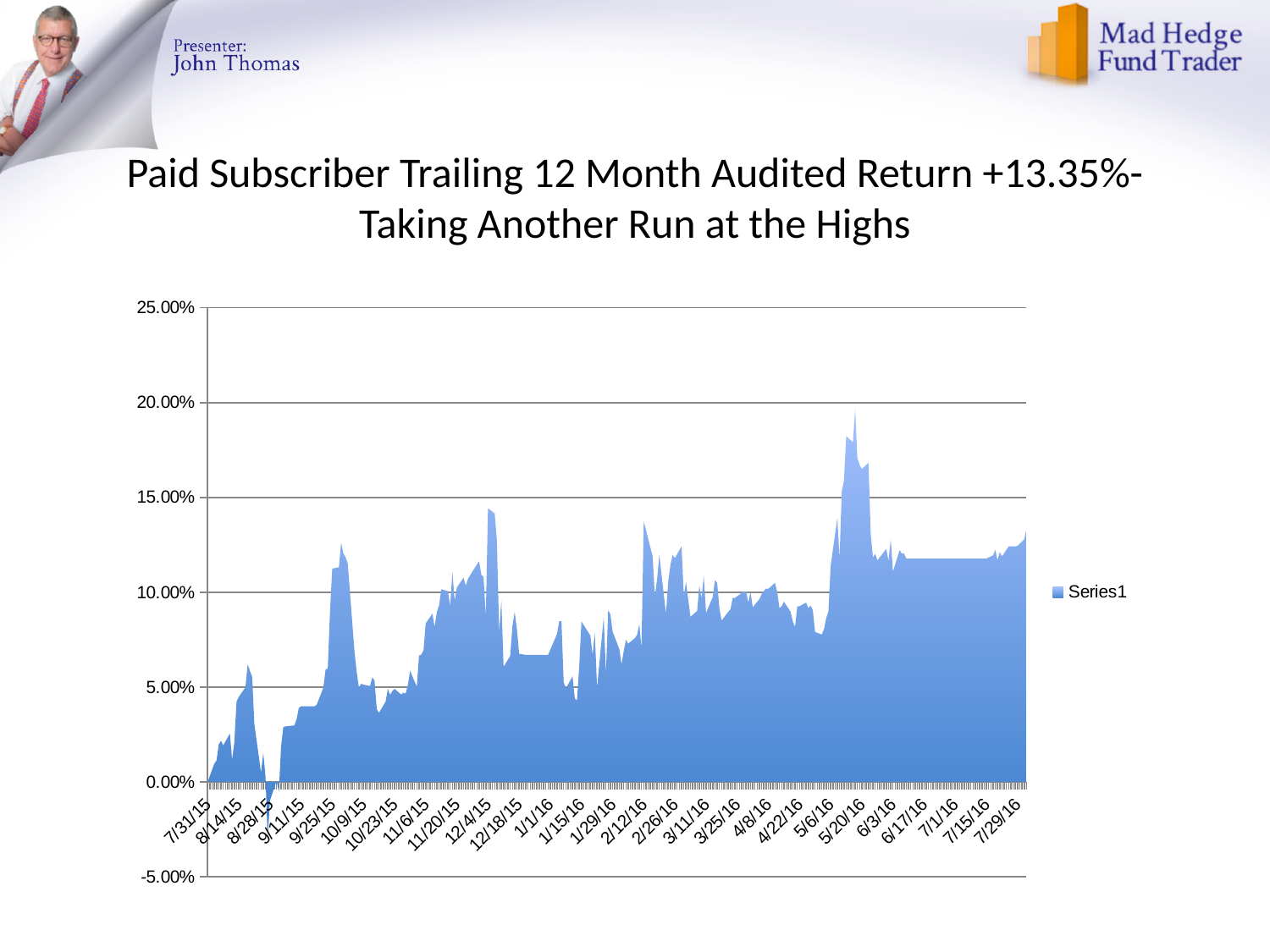
What is the name of the series shown in the legend? Series1 What kind of chart is shown on the slide? area chart Near which labeled date does the series reach its highest value? 5/20/16 Overall, does the series rise or fall from 7/31/15 to 7/29/16? rise Is the value at 7/1/16 greater or less than 10.00%? greater What trailing 12 month audited return does the chart title state? +13.35% Near which labeled date does the series reach its lowest value? 8/28/15 Is the value at 7/29/16 greater or less than 20.00%? less Is the value at 7/31/15 greater or less than 5.00%? less How many series does the legend list? 1